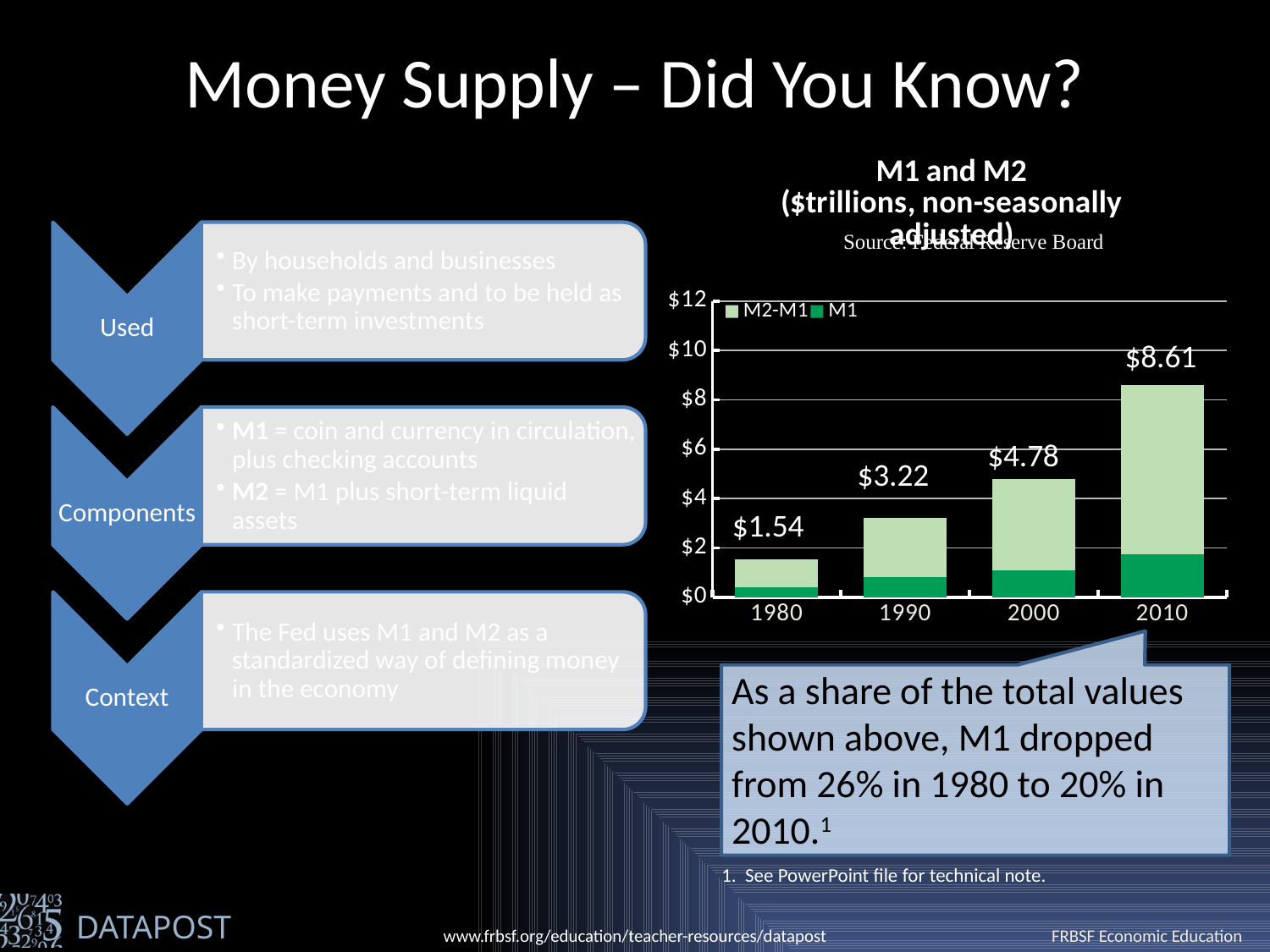
Is the M1 value for 1980 greater or less than $2? less Which year has the highest total value? 2010 What is the total value shown for 2010? $8.61 How many years are shown on the x axis? 4 How many series does the legend list? 2 Do the total values rise or fall from 1980 to 2010? rise What is the difference between the total values for 2010 and 1980? $7.07 Which is larger, the total value for 2000 or for 1990? 2000 What kind of chart is shown? stacked bar chart What is the total value shown for 1990? $3.22 Which year has the lowest total value? 1980 What is the total value shown for 1980? $1.54